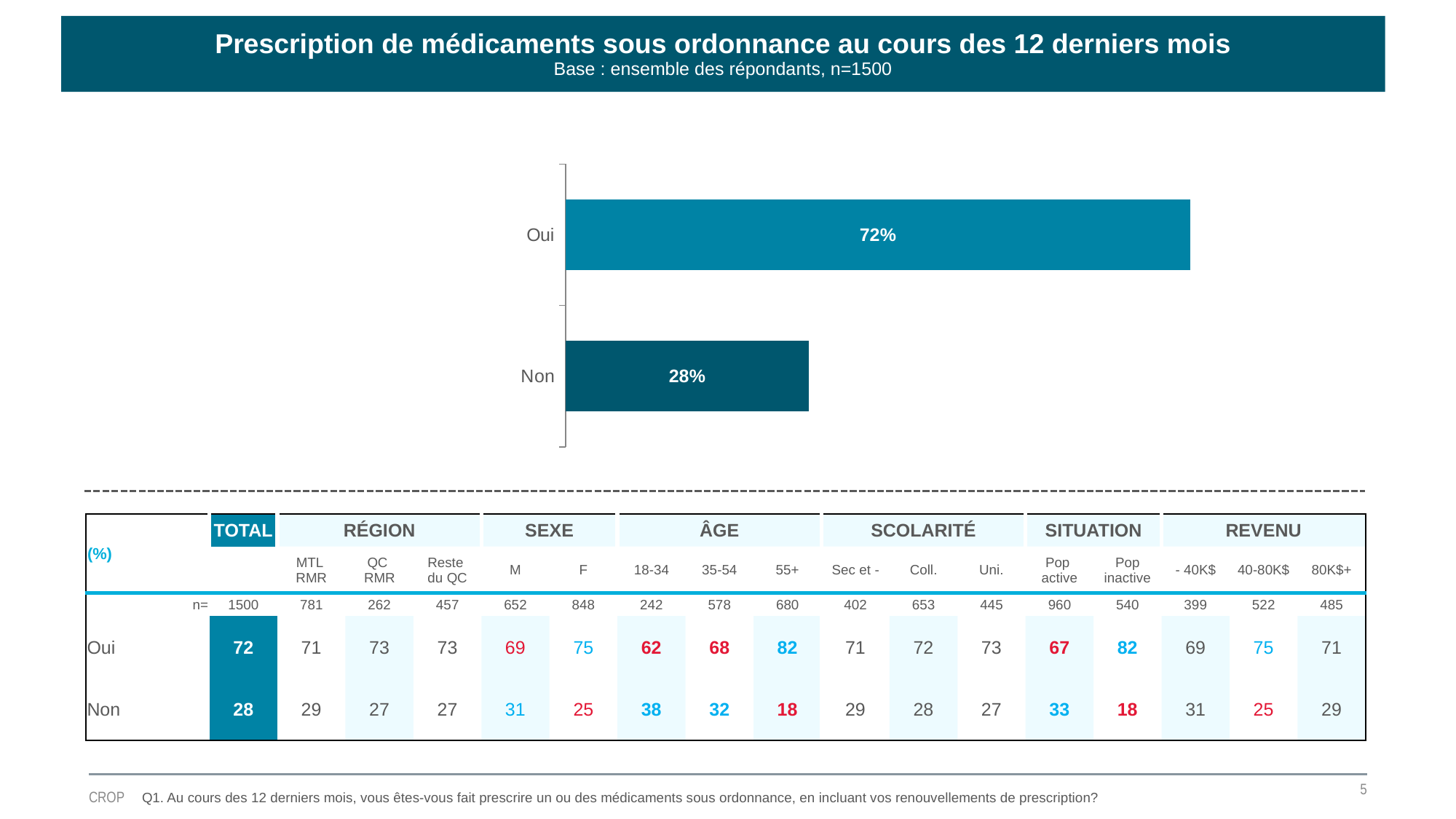
Which category has the lowest value in the bar chart? Non What is the value for Oui in the bar chart? 72% How many categories are shown in the bar chart? 2 What is the base (n) stated under the chart title? n=1500 What is the value for Non in the bar chart? 28% What is the total of the Oui and Non values in the bar chart? 100% What is the difference between the Oui and Non values in the bar chart? 44% Which category has the highest value in the bar chart? Oui Which is larger in the bar chart, Oui or Non? Oui What kind of chart is shown on the slide? Bar chart What is the title of the chart on the slide? Prescription de médicaments sous ordonnance au cours des 12 derniers mois